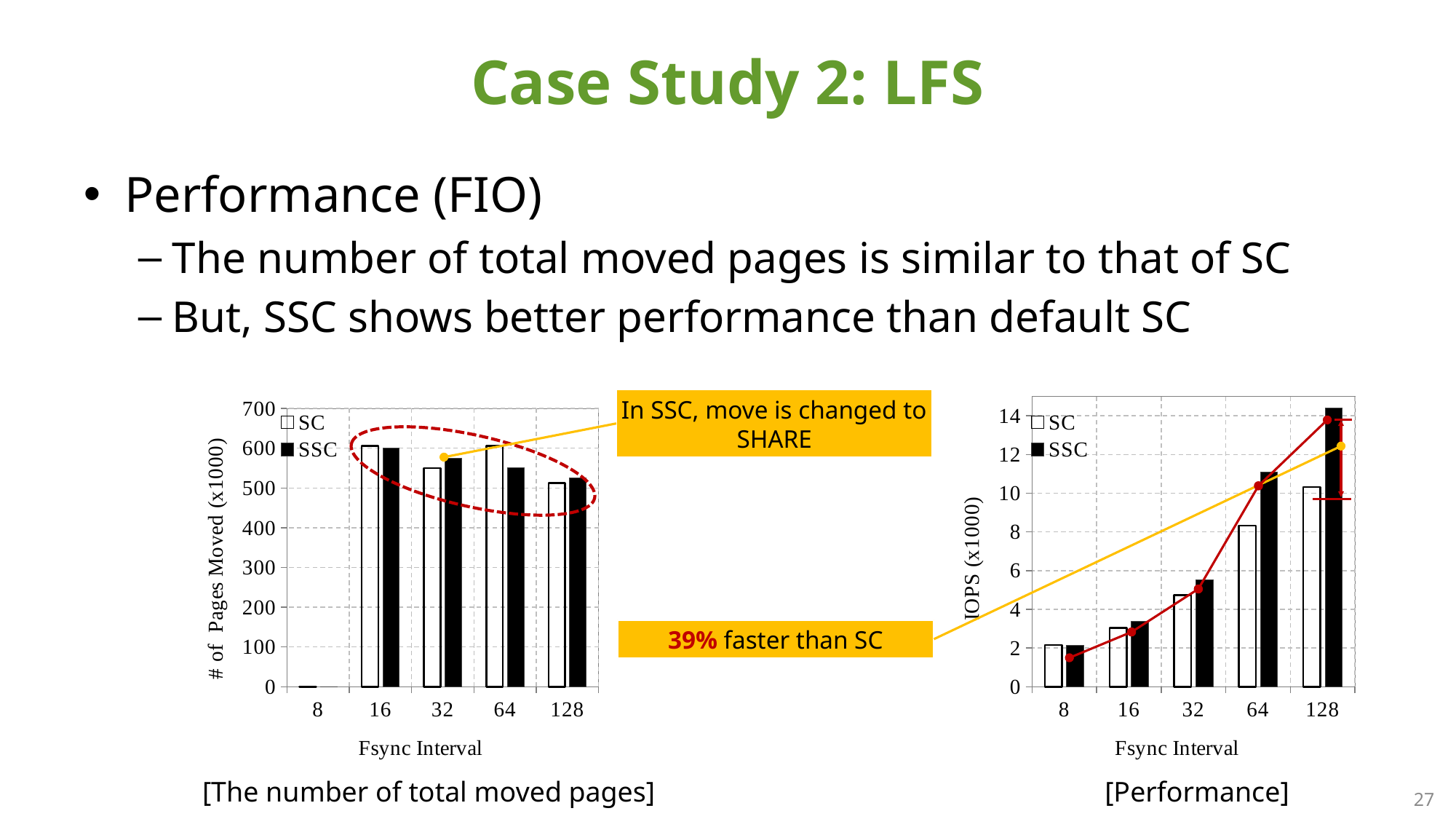
In the [Performance] chart, which Fsync Interval has the highest SSC value? 128 What is the y-axis label of the [Performance] chart? IOPS (x1000) In the [The number of total moved pages] chart, which Fsync Interval has the lowest SC value? 8 What kind of chart is the [The number of total moved pages] chart? bar chart In the [The number of total moved pages] chart, is the SC value at Fsync Interval 128 greater or less than 600? less In the [Performance] chart, is the SC value at Fsync Interval 64 greater or less than 10? less How many Fsync Interval categories are shown on the x axis of the [Performance] chart? 5 How many series does the legend of the [Performance] chart list? 2 In the [The number of total moved pages] chart, at Fsync Interval 64, which series has the larger value, SC or SSC? SC In the [The number of total moved pages] chart, is the SSC value at Fsync Interval 16 greater or less than 500? greater In the [Performance] chart, at Fsync Interval 128, which series has the larger value, SC or SSC? SSC In the [Performance] chart, do the SSC values rise or fall as the Fsync Interval increases? rise